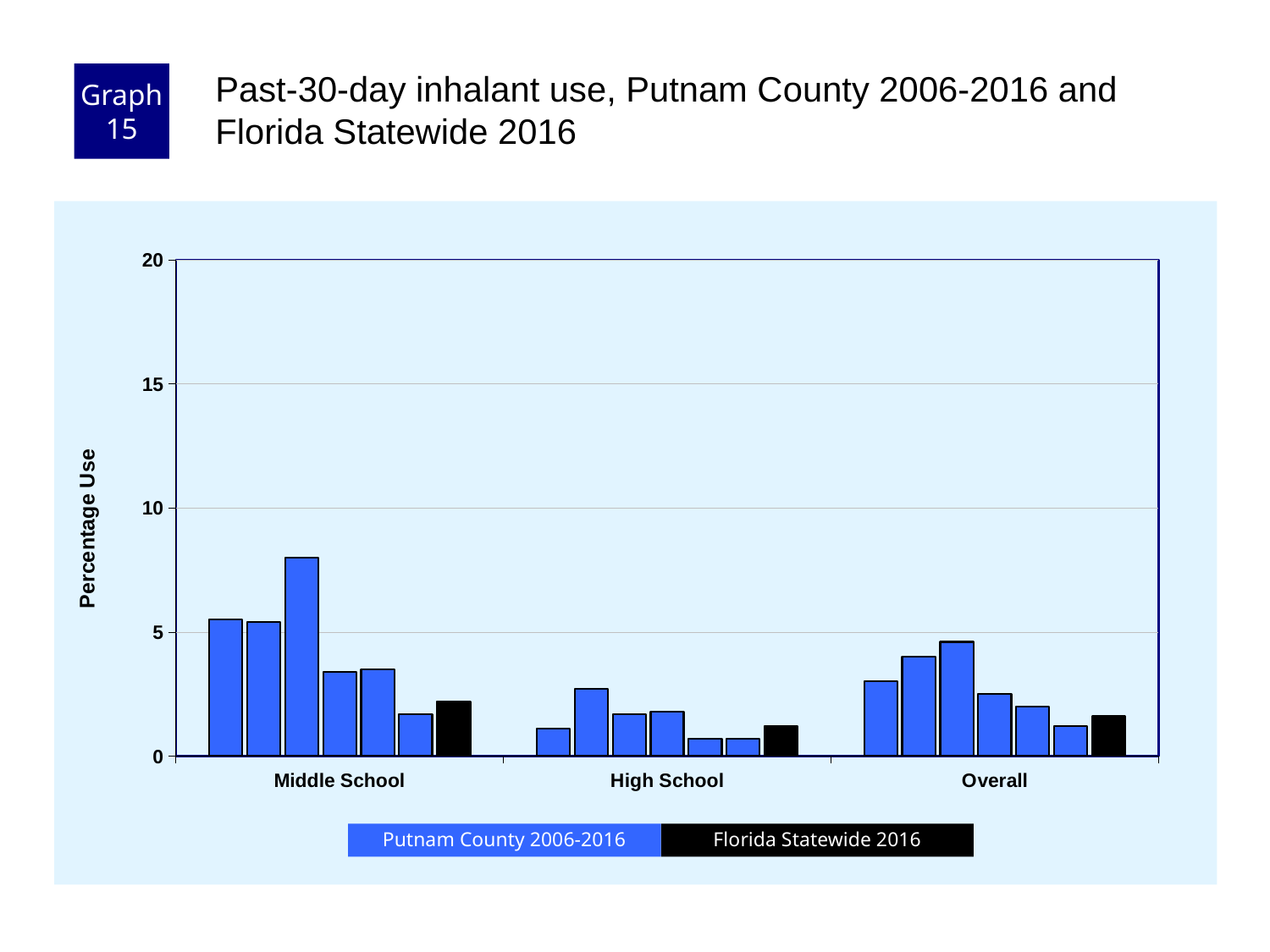
Is the tallest bar in the Overall group greater or less than 10? less What kind of chart is shown on the slide? bar chart How many bars are plotted in the Middle School group? 7 Which category contains the tallest bar on the chart? Middle School Is the Florida Statewide 2016 value for Middle School greater or less than 5? less Is the tallest bar in the High School group greater or less than 5? less How many series does the legend list? 2 What colour are the Florida Statewide 2016 bars? black How many categories are shown along the x axis? 3 Which is larger, the Florida Statewide 2016 value for Middle School or for High School? Middle School What is the label on the y axis? Percentage Use